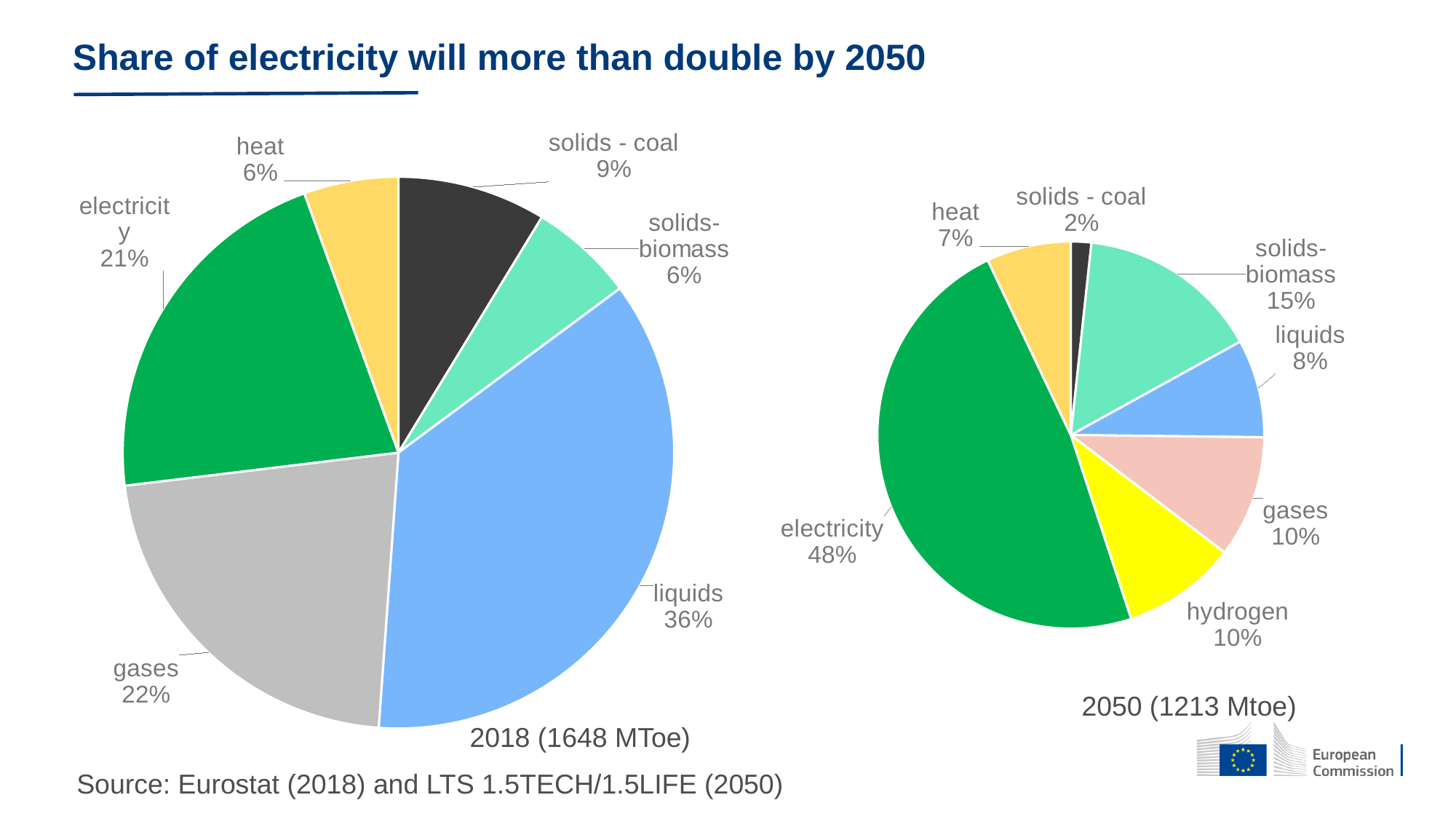
How many slices does the 2050 (1213 Mtoe) pie chart have? 7 How many slices does the 2018 (1648 MToe) pie chart have? 6 In the 2018 (1648 MToe) pie chart, which category has the largest share? liquids What type of chart is used on this slide? pie chart What is the difference between the electricity share in the 2050 pie chart and the electricity share in the 2018 pie chart? 27 percentage points In the 2050 (1213 Mtoe) pie chart, what share does electricity have? 48% In the 2050 (1213 Mtoe) pie chart, what share does hydrogen have? 10% Which category appears in the 2050 pie chart but not in the 2018 pie chart? hydrogen In the 2018 (1648 MToe) pie chart, which is larger: the share of gases or the share of electricity? gases In the 2018 (1648 MToe) pie chart, what share does liquids have? 36% In the 2018 (1648 MToe) pie chart, what share does solids - coal have? 9% In the 2050 (1213 Mtoe) pie chart, which category has the smallest share? solids - coal